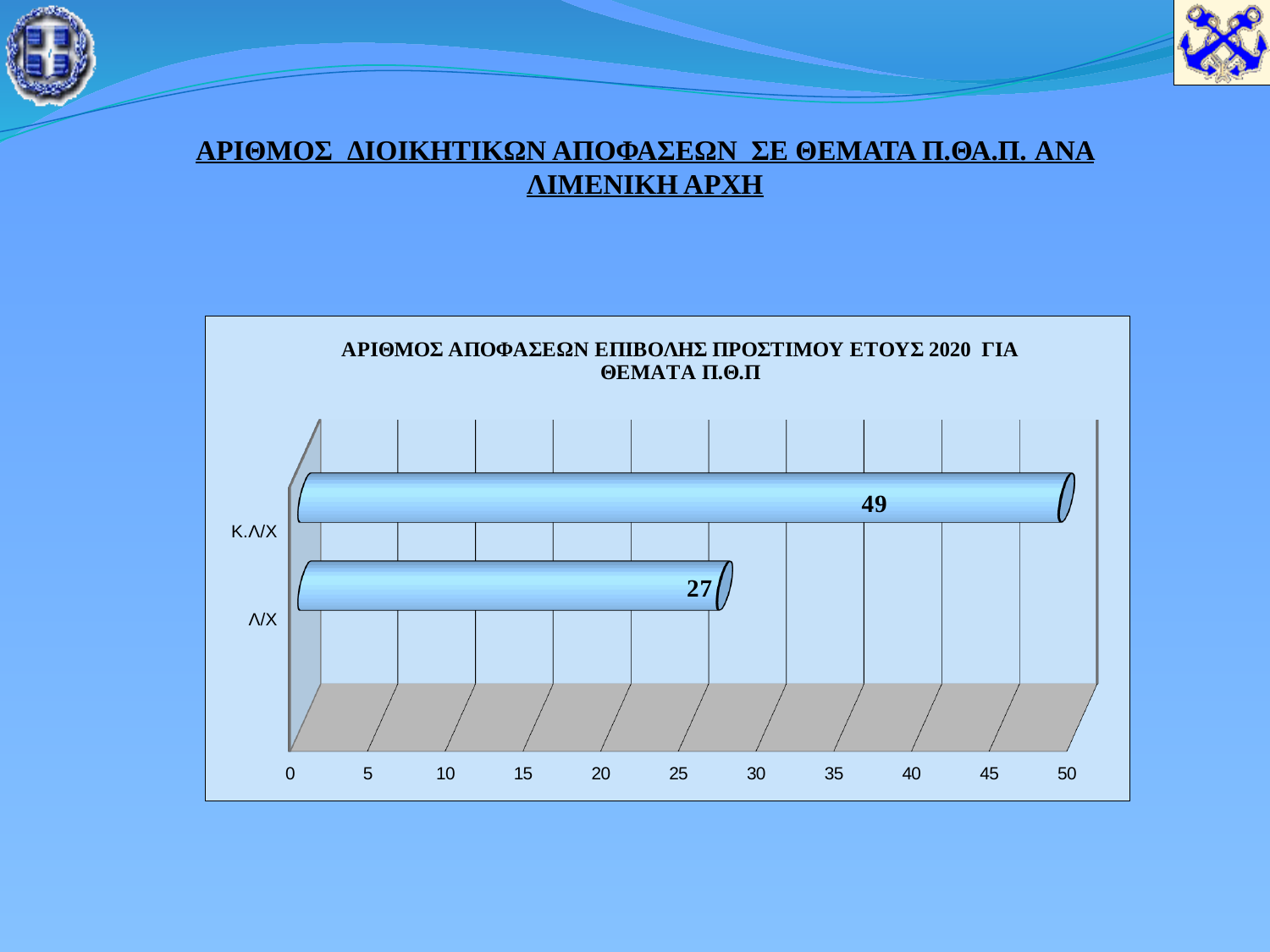
Is the value for Λ/Χ greater or less than 30? less Which category has the lowest value? Λ/Χ Is the value for Κ.Λ/Χ greater or less than 45? greater What is the difference between the values for Κ.Λ/Χ and Λ/Χ? 22 Which is larger, the value for Κ.Λ/Χ or the value for Λ/Χ? Κ.Λ/Χ What is the total of the two values shown in the chart? 76 What is the value for Κ.Λ/Χ? 49 How many categories are shown in the chart? 2 Which category has the highest value? Κ.Λ/Χ What kind of chart is shown on the slide? bar chart What is the value for Λ/Χ? 27 What is the maximum value shown on the horizontal axis of the chart? 50